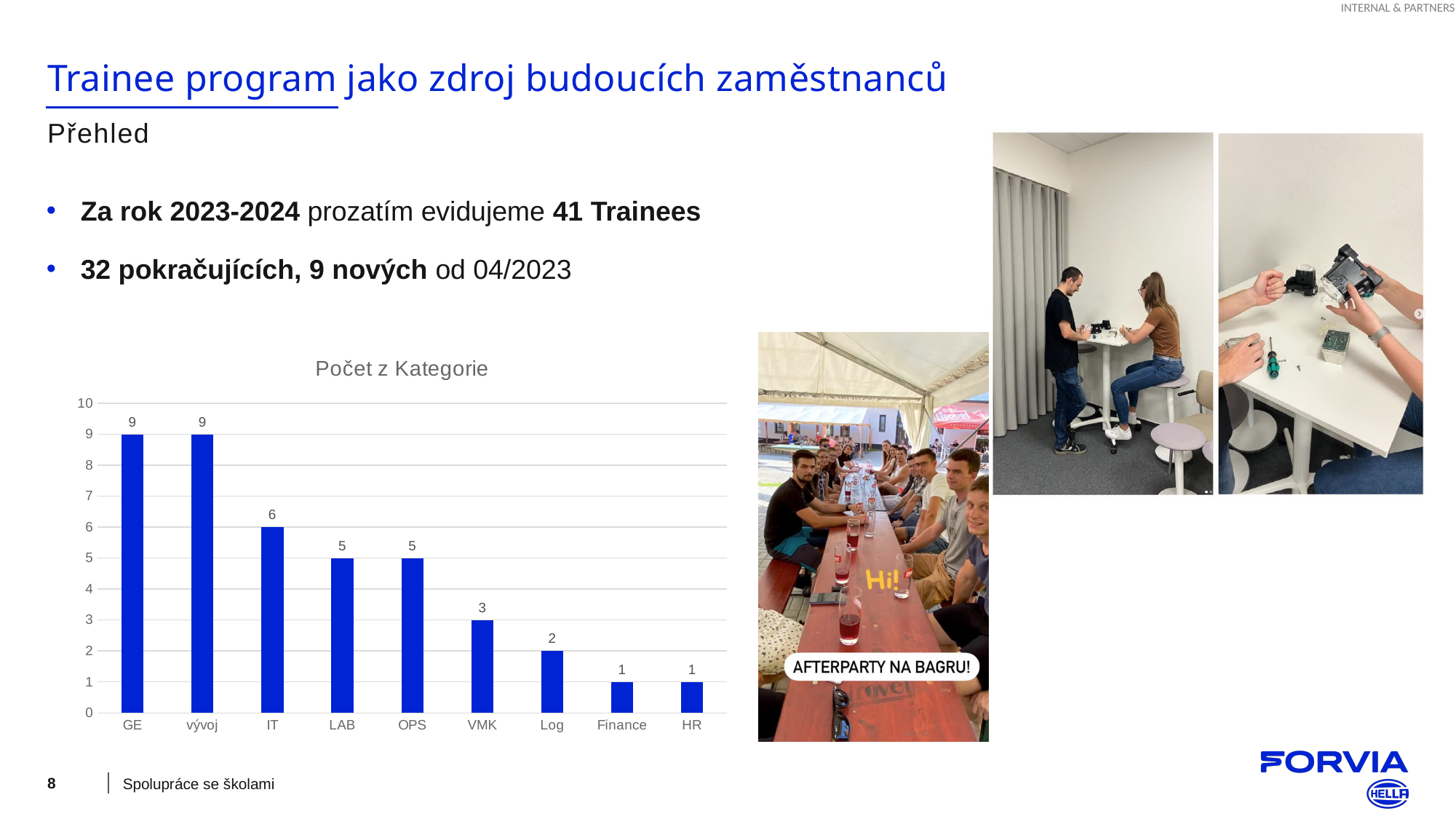
Which category has the lowest value in the chart? Finance and HR (both 1) Is the value for vývoj greater or less than 5? greater What is the difference between the values for GE and IT? 3 Do the values rise or fall from left to right along the x axis? fall What is the value for Log in the chart? 2 What is the value for VMK in the chart? 3 What is the value for IT in the chart? 6 How many categories are shown on the x axis of the chart? 9 What is the title of the chart? Počet z Kategorie Which is larger, the value for IT or the value for OPS? IT What kind of chart is shown on the slide? bar chart What is the difference between the values for LAB and Log? 3